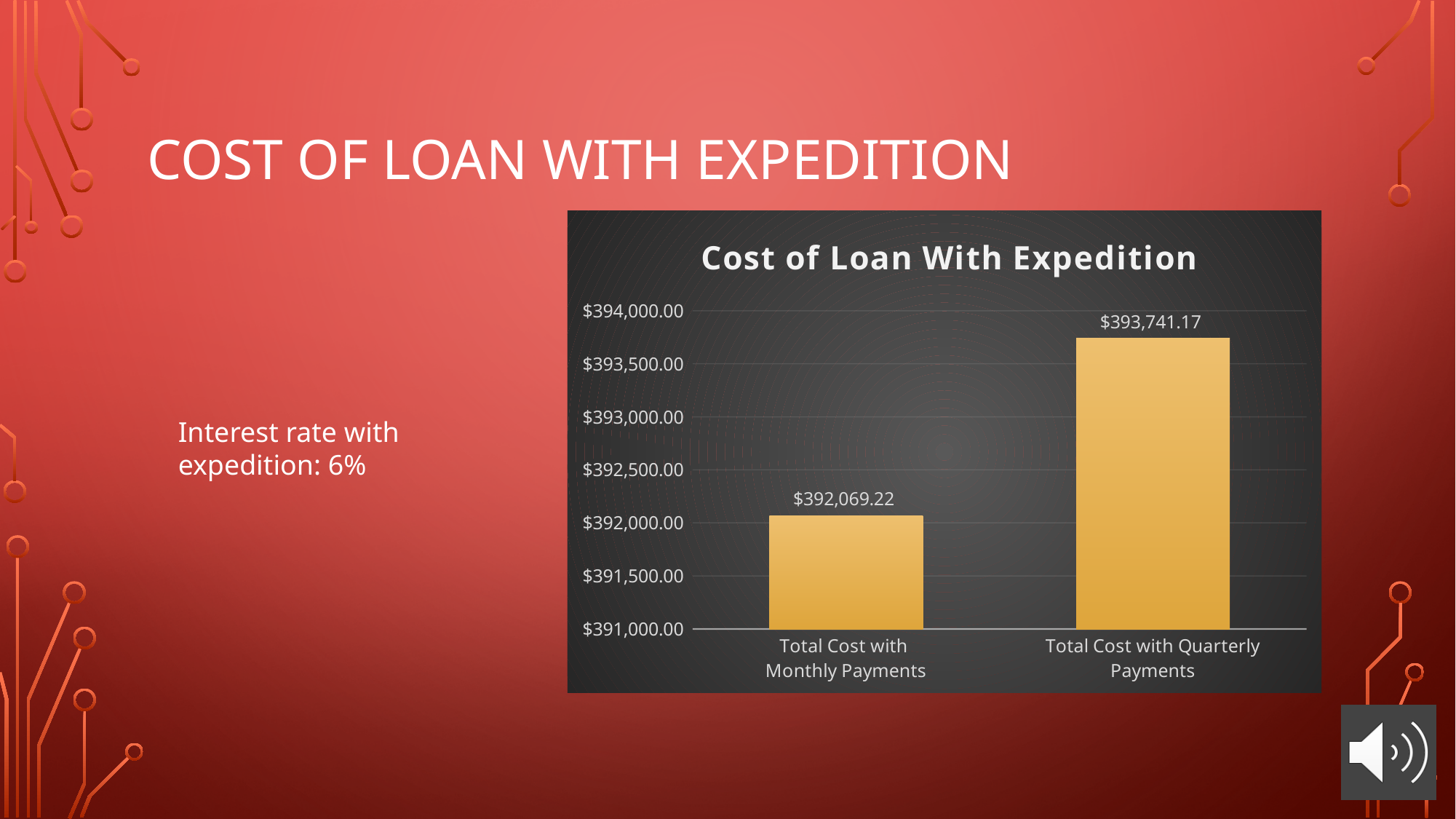
What is the highest value shown on the chart's vertical axis? $394,000.00 Which category has the higher total cost? Total Cost with Quarterly Payments What is the difference between the total cost with quarterly payments and the total cost with monthly payments? $1,671.95 Which category has the lower total cost? Total Cost with Monthly Payments What is the title of the chart? Cost of Loan With Expedition Is the value for Total Cost with Monthly Payments greater or less than $392,500.00? less What kind of chart is shown on the slide? bar chart How many categories are plotted on the chart? 2 What is the total cost with monthly payments shown on the chart? $392,069.22 Is the total cost with monthly payments larger or smaller than the total cost with quarterly payments? smaller What is the total cost with quarterly payments shown on the chart? $393,741.17 Is the value for Total Cost with Quarterly Payments greater or less than $393,500.00? greater